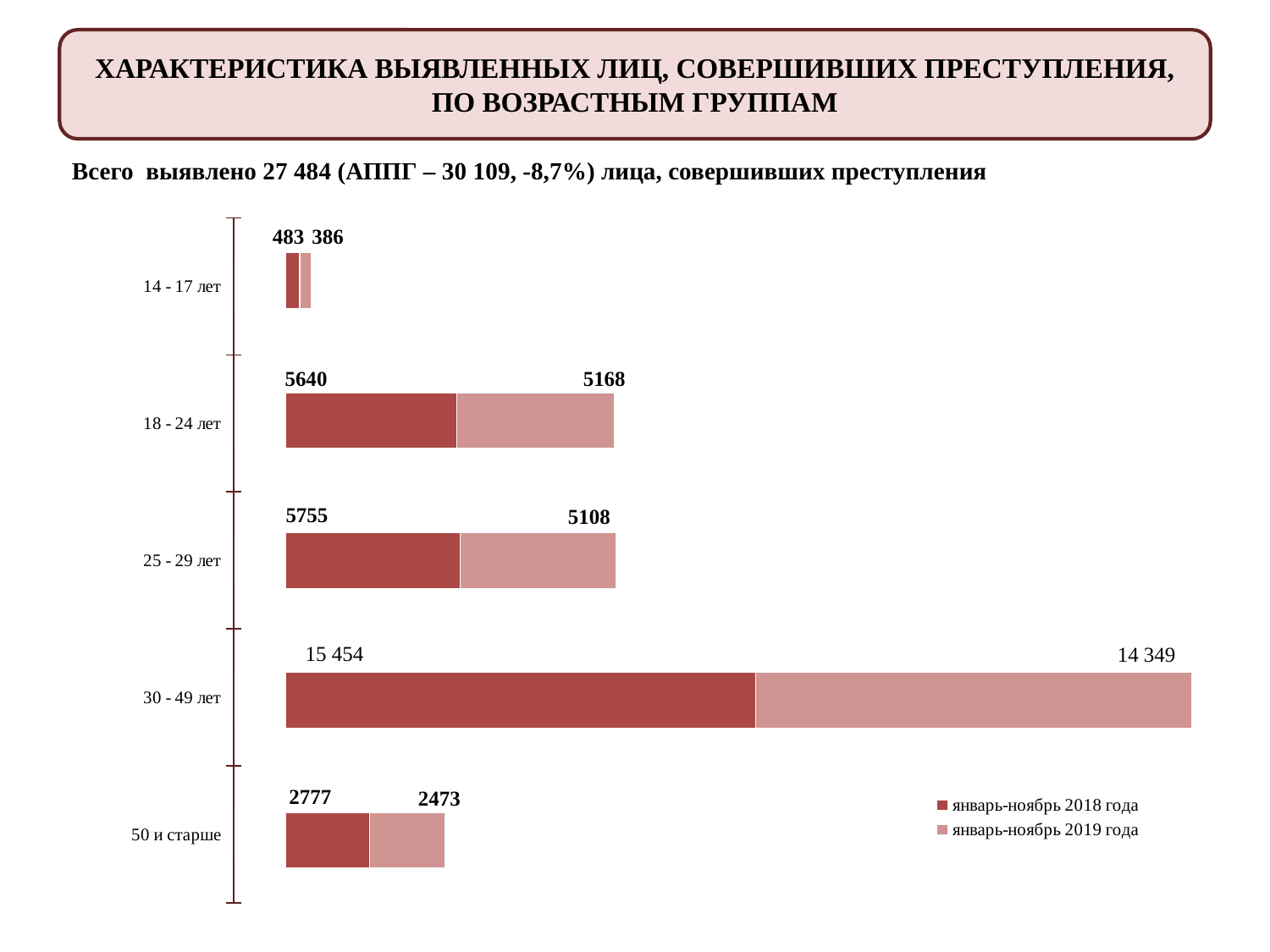
What is the value for the 30 - 49 лет age group in январь-ноябрь 2018 года? 15 454 What is the difference between the 2018 and 2019 values for the 18 - 24 лет age group? 472 Which age group has the highest value in январь-ноябрь 2019 года? 30 - 49 лет What is the value for the 50 и старше age group in январь-ноябрь 2018 года? 2777 How many age groups are shown on the chart? 5 How many series does the legend list? 2 Which age group has the lowest value in январь-ноябрь 2018 года? 14 - 17 лет What is the value for the 14 - 17 лет age group in январь-ноябрь 2019 года? 386 What kind of chart is shown on the slide? Stacked bar chart Which is larger for the 25 - 29 лет age group: the январь-ноябрь 2018 года value or the январь-ноябрь 2019 года value? январь-ноябрь 2018 года What is the total of the stacked bar for the 50 и старше age group? 5250 What is the value for the 25 - 29 лет age group in январь-ноябрь 2019 года? 5108